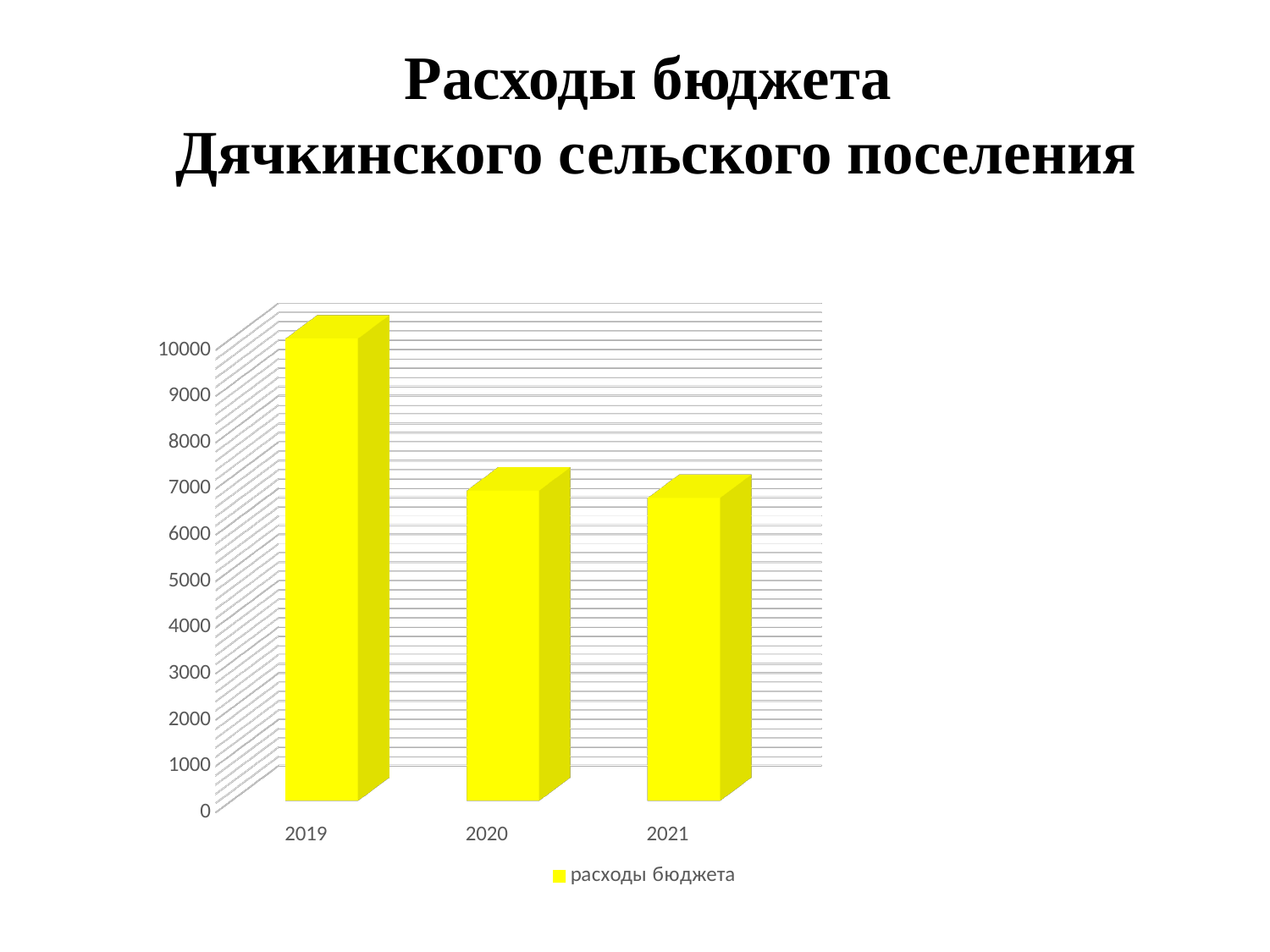
Which is larger, the value for 2019 or the value for 2021? 2019 Is the value for 2020 greater or less than 6000? greater Is the value for 2019 greater or less than 9000? greater Do the values rise or fall from 2019 to 2021? fall How many series does the chart legend list? 1 How many years are shown on the x axis of the chart? 3 Which year has the highest budget expenditure in the chart? 2019 Is the value for 2020 greater or less than 8000? less What is the name of the series shown in the chart legend? расходы бюджета What kind of chart is shown on the slide? bar chart